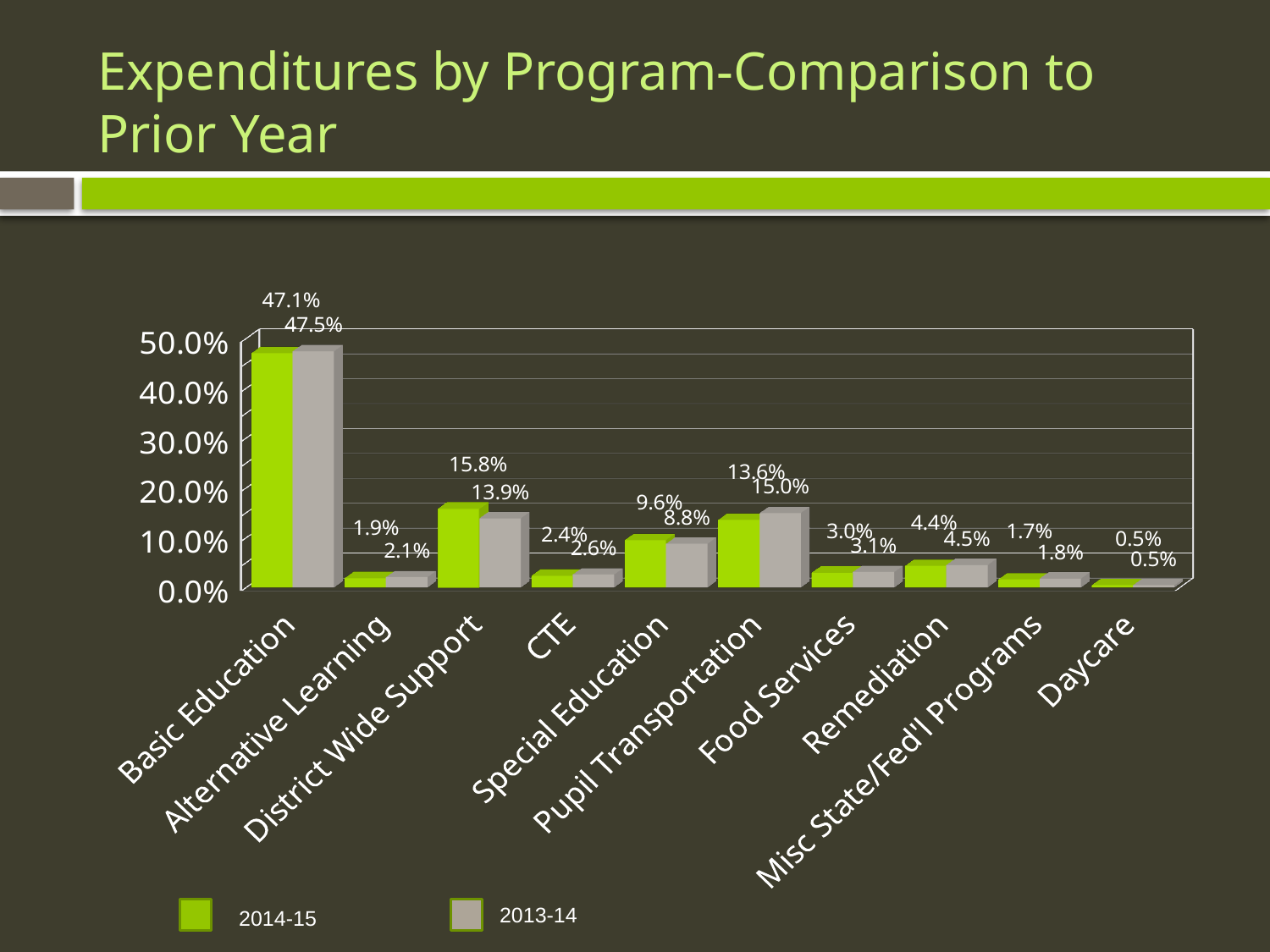
How many program categories are shown on the x axis? 10 What is the 2014-15 value for Basic Education? 47.1% What is the 2014-15 value for District Wide Support? 15.8% Which program has the lowest 2013-14 expenditure share? Daycare Which program has the highest 2014-15 expenditure share? Basic Education Which is larger for Pupil Transportation, the 2014-15 value or the 2013-14 value? 2013-14 How many series does the legend list? 2 What is the difference between the 2014-15 and 2013-14 values for District Wide Support? 1.9% Is the 2014-15 value for Special Education greater or less than 10.0%? less What is the 2013-14 value for Pupil Transportation? 15.0% Which series is shown in green? 2014-15 What kind of chart is shown on the slide? Bar chart